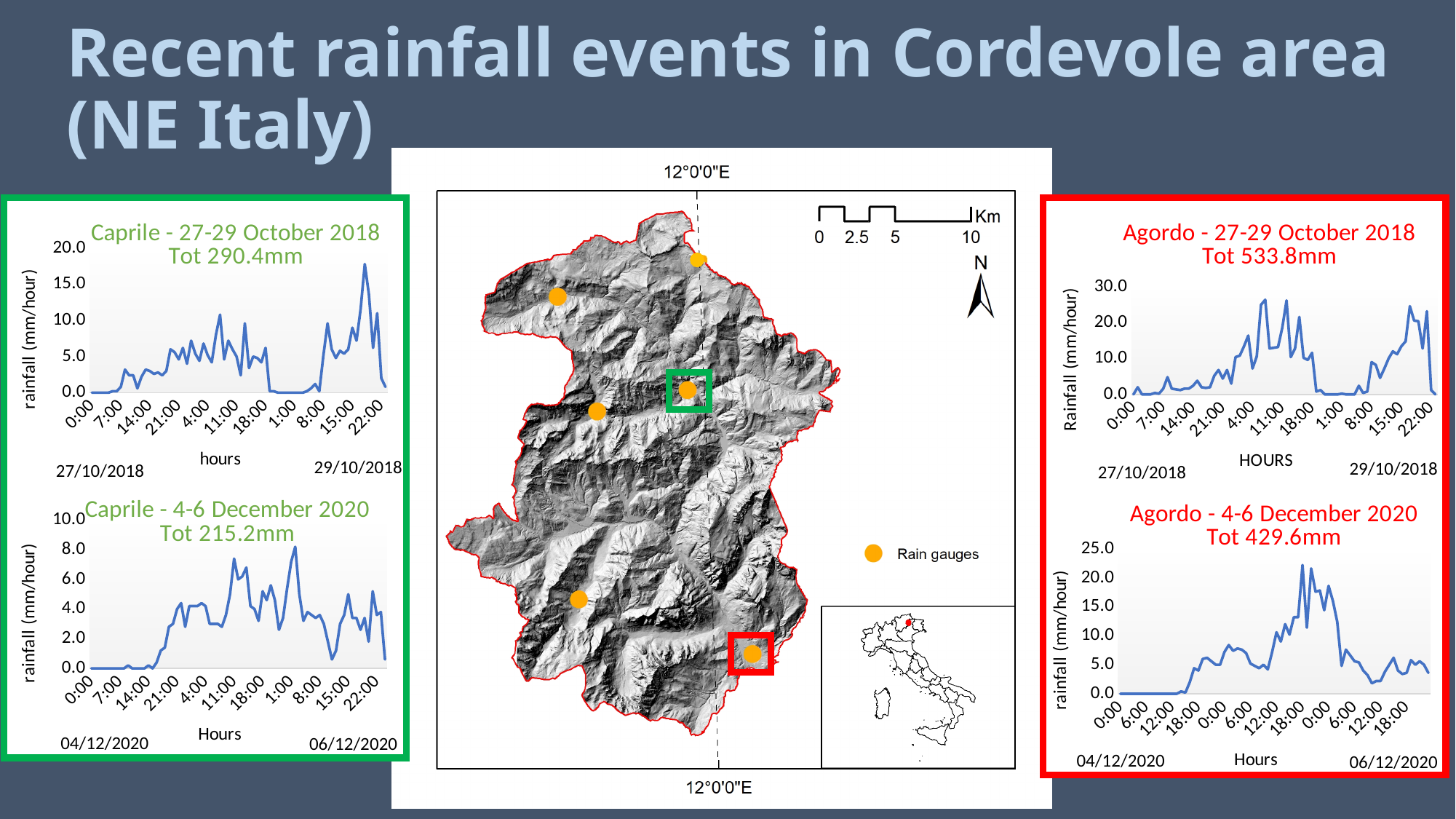
In the 'Caprile - 27-29 October 2018' chart, is the peak rainfall value greater or less than 15.0 mm/hour? greater What is the total rainfall shown for the 'Caprile - 4-6 December 2020' chart? 215.2mm In the 'Caprile - 4-6 December 2020' chart, is the peak rainfall value greater or less than 10.0 mm/hour? less How many rainfall charts are shown on the slide? 4 What is the total rainfall shown for the 'Agordo - 27-29 October 2018' chart? 533.8mm Which of the four rainfall events has the lowest total rainfall? Caprile - 4-6 December 2020 What kind of chart is the 'Caprile - 27-29 October 2018' chart? line chart For the 4-6 December 2020 event, which station recorded a larger total rainfall, Agordo or Caprile? Agordo What is the difference between the total rainfall at Agordo and at Caprile for the 27-29 October 2018 event? 243.4mm In the 'Agordo - 27-29 October 2018' chart, is the peak rainfall value greater or less than 20.0 mm/hour? greater What is the highest value shown on the y-axis of the 'Agordo - 27-29 October 2018' chart? 30.0 Which of the four rainfall events has the highest total rainfall? Agordo - 27-29 October 2018